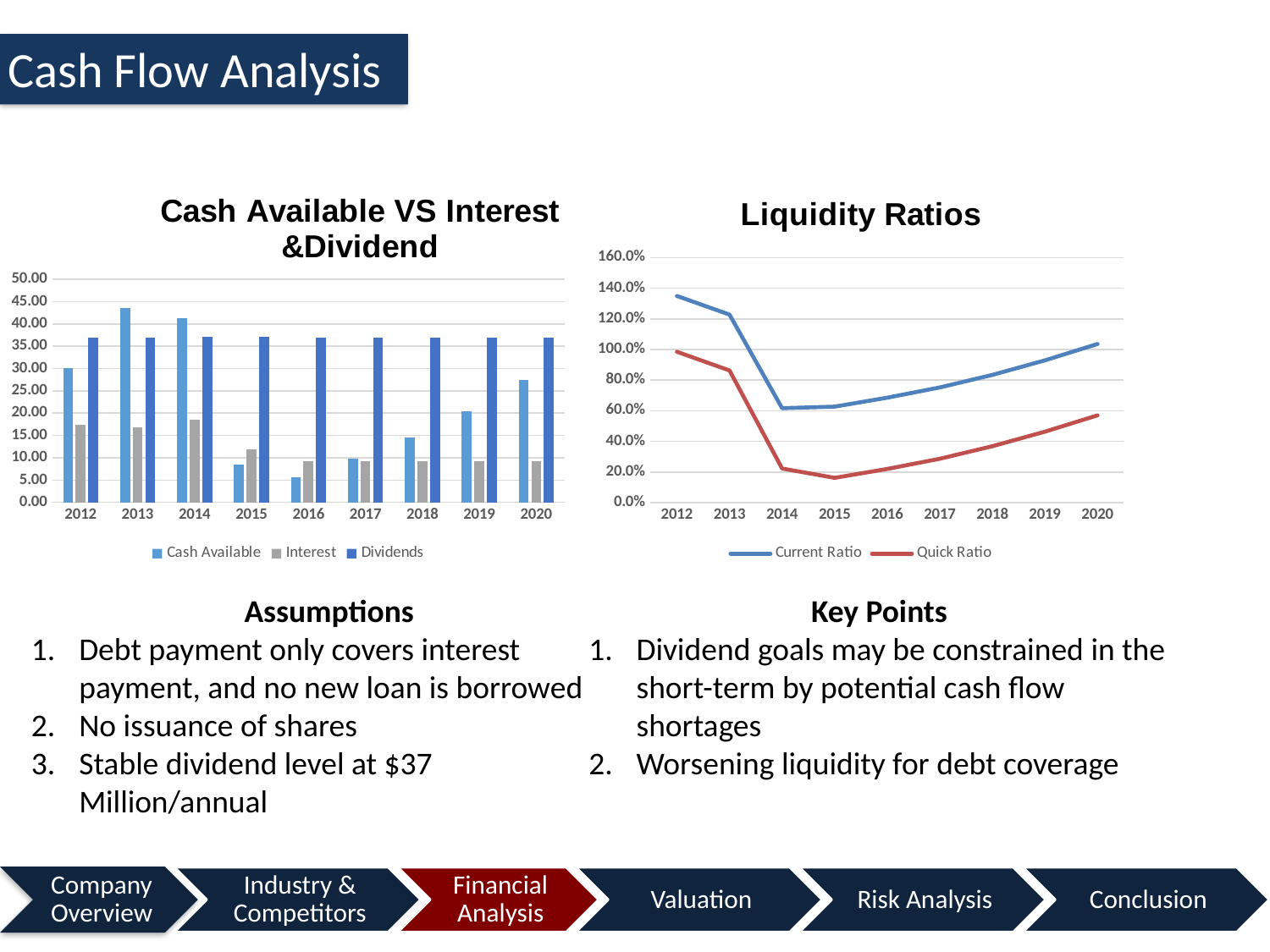
In the 'Liquidity Ratios' chart, does the Quick Ratio rise or fall from 2015 to 2020? rise In the 'Cash Available VS Interest &Dividend' chart, which year has the lowest Cash Available value? 2016 In the 'Cash Available VS Interest &Dividend' chart, is the Cash Available value for 2013 greater or less than 40.00? greater In the 'Liquidity Ratios' chart, which year has the lowest Quick Ratio? 2015 In the 'Cash Available VS Interest &Dividend' chart, is Cash Available or Dividends larger in 2015? Dividends How many series does the legend of the 'Cash Available VS Interest &Dividend' chart list? 3 In the 'Liquidity Ratios' chart, is the Current Ratio for 2012 greater or less than 120.0%? greater How many years are shown on the x axis of the 'Liquidity Ratios' chart? 9 In the 'Cash Available VS Interest &Dividend' chart, which year has the highest Cash Available value? 2013 What kind of chart is the 'Cash Available VS Interest &Dividend' chart? bar chart How many series does the legend of the 'Liquidity Ratios' chart list? 2 What kind of chart is the 'Liquidity Ratios' chart? line chart